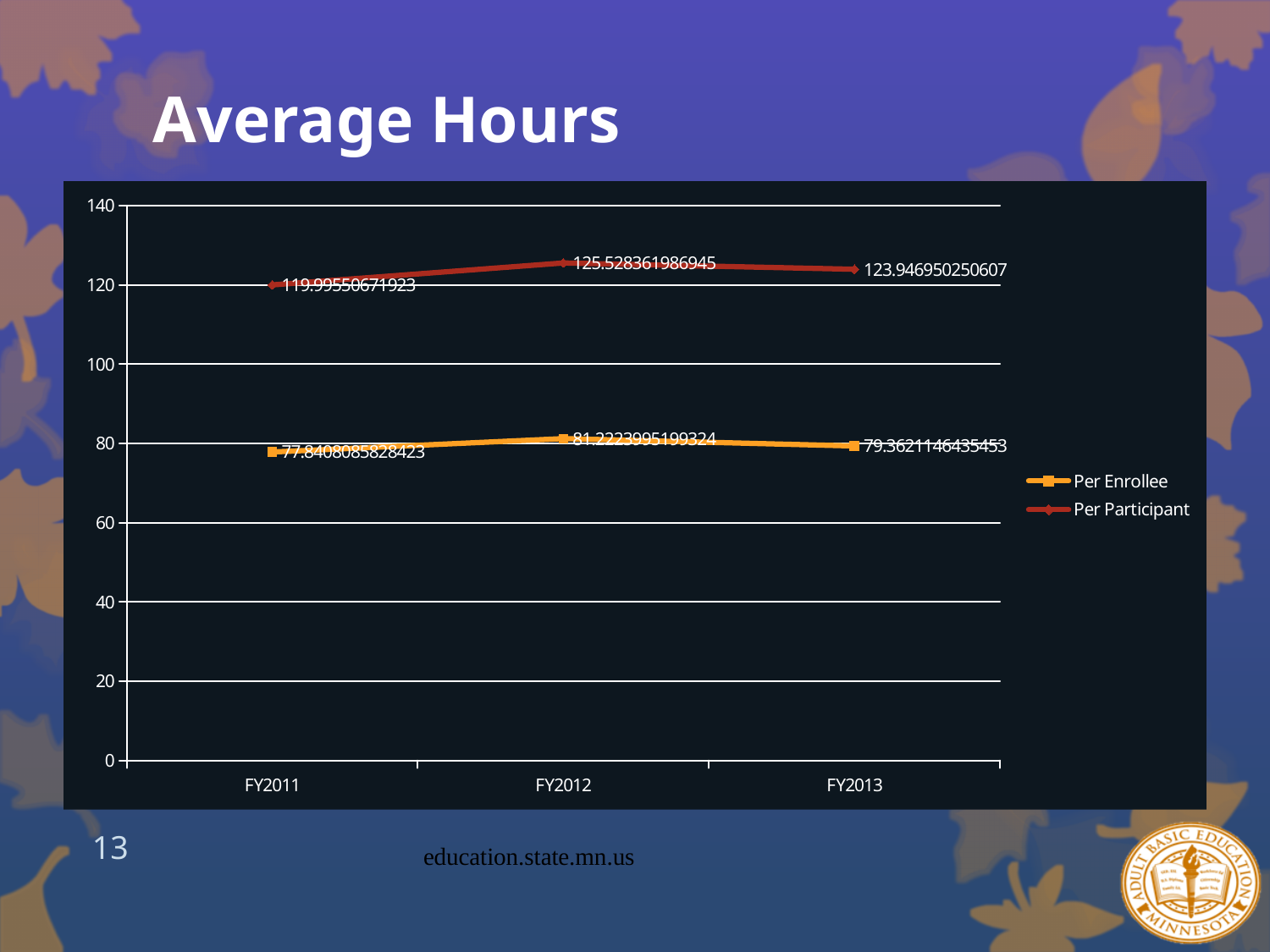
In which fiscal year is the Per Participant value highest? FY2012 What is the title of the chart? Average Hours Which series has the larger value in FY2013, Per Enrollee or Per Participant? Per Participant What is the Per Participant value for FY2012? 125.528361986945 How many fiscal years are shown on the x axis? 3 How many series does the legend list? 2 Which series is drawn in orange in the legend? Per Enrollee In which fiscal year is the Per Enrollee value lowest? FY2011 What is the Per Participant value for FY2013? 123.946950250607 What is the Per Enrollee value for FY2013? 79.3621146435453 Is the Per Participant value for FY2012 greater or less than 120? greater What type of chart is shown on the slide? line chart